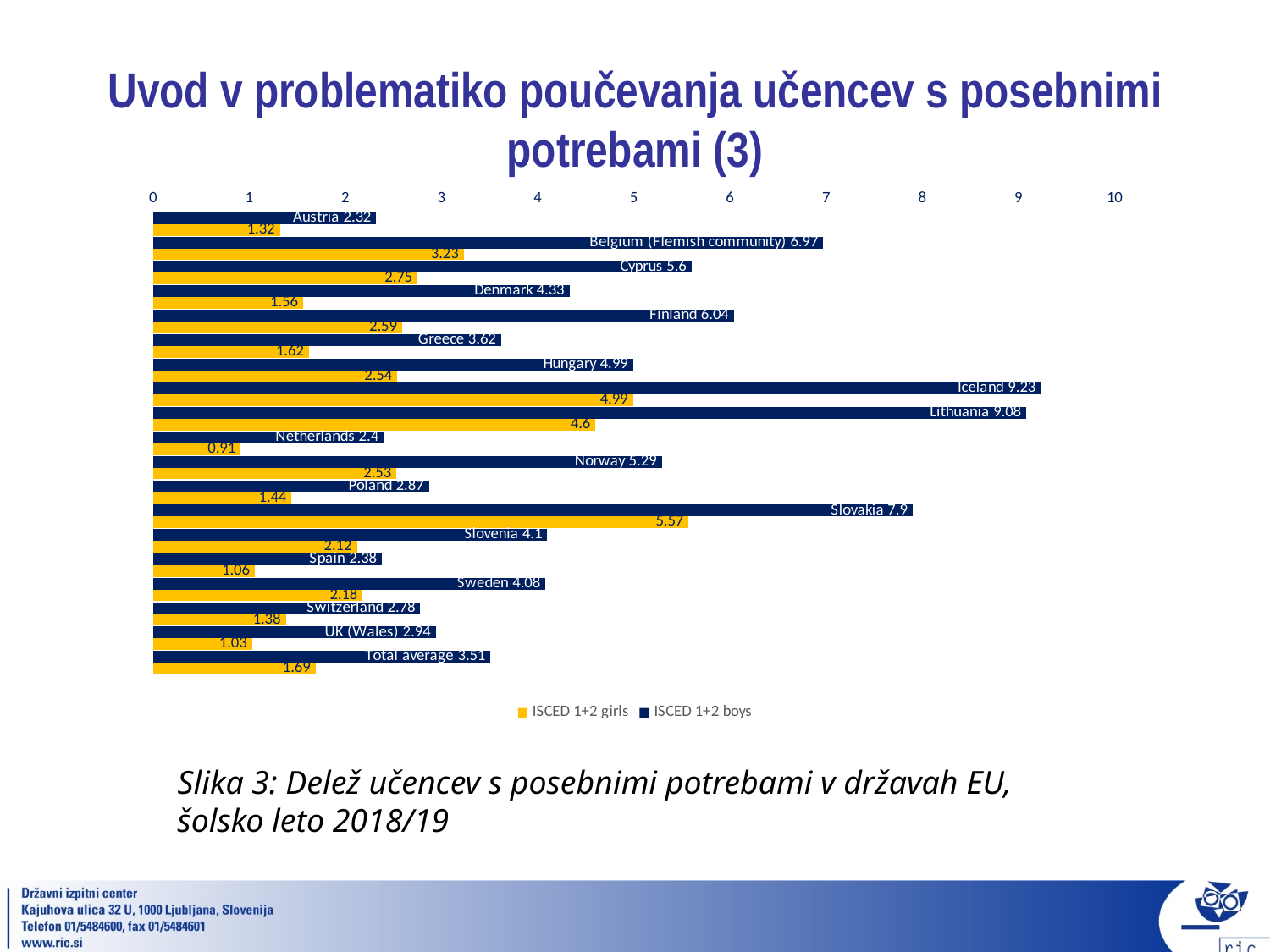
What is the difference between the ISCED 1+2 boys and girls values for Belgium (Flemish community)? 3.74 How many series does the legend list? 2 Which country has the highest ISCED 1+2 boys value? Iceland What is the ISCED 1+2 boys value for Slovenia? 4.1 Which is larger, the ISCED 1+2 boys value for Finland or for Cyprus? Finland What is the ISCED 1+2 girls value for the Netherlands? 0.91 What is the ISCED 1+2 girls value for Slovakia? 5.57 What is the ISCED 1+2 boys value for Iceland? 9.23 What is the ISCED 1+2 boys value for the Total average? 3.51 What kind of chart is shown on the slide? Bar chart How many categories (countries plus the total average) are shown in the chart? 19 Which country has the lowest ISCED 1+2 girls value? Netherlands